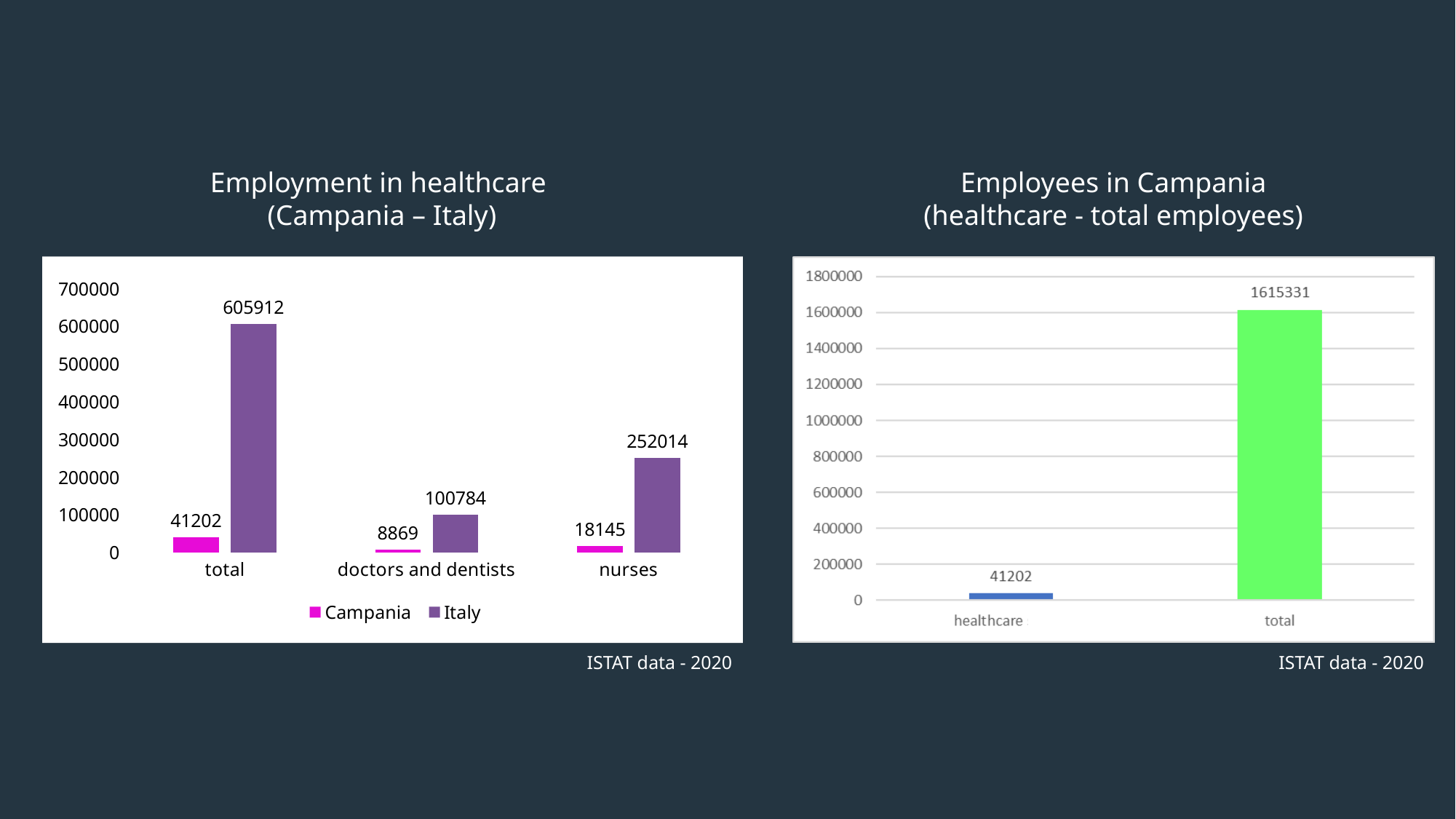
What kind of chart is the 'Employees in Campania (healthcare - total employees)' chart? bar chart In the 'Employment in healthcare (Campania – Italy)' chart, what is the value for Campania for 'doctors and dentists'? 8869 In the 'Employees in Campania (healthcare - total employees)' chart, what is the difference between the 'total' and 'healthcare' values? 1574129 In the 'Employment in healthcare (Campania – Italy)' chart, how many categories are shown on the x axis? 3 In the 'Employment in healthcare (Campania – Italy)' chart, what is the value for Campania in the 'nurses' category? 18145 In the 'Employment in healthcare (Campania – Italy)' chart, what is the difference between the Italy and Campania values for 'nurses'? 233869 In the 'Employment in healthcare (Campania – Italy)' chart, how many series does the legend list? 2 In the 'Employment in healthcare (Campania – Italy)' chart, which is larger: Italy's value for 'doctors and dentists' or Italy's value for 'nurses'? nurses In the 'Employment in healthcare (Campania – Italy)' chart, which category has the lowest value for Italy? doctors and dentists In the 'Employment in healthcare (Campania – Italy)' chart, what colour are the Campania bars? magenta In the 'Employees in Campania (healthcare - total employees)' chart, what is the value for 'total'? 1615331 In the 'Employment in healthcare (Campania – Italy)' chart, what is the value for Italy in the 'total' category? 605912